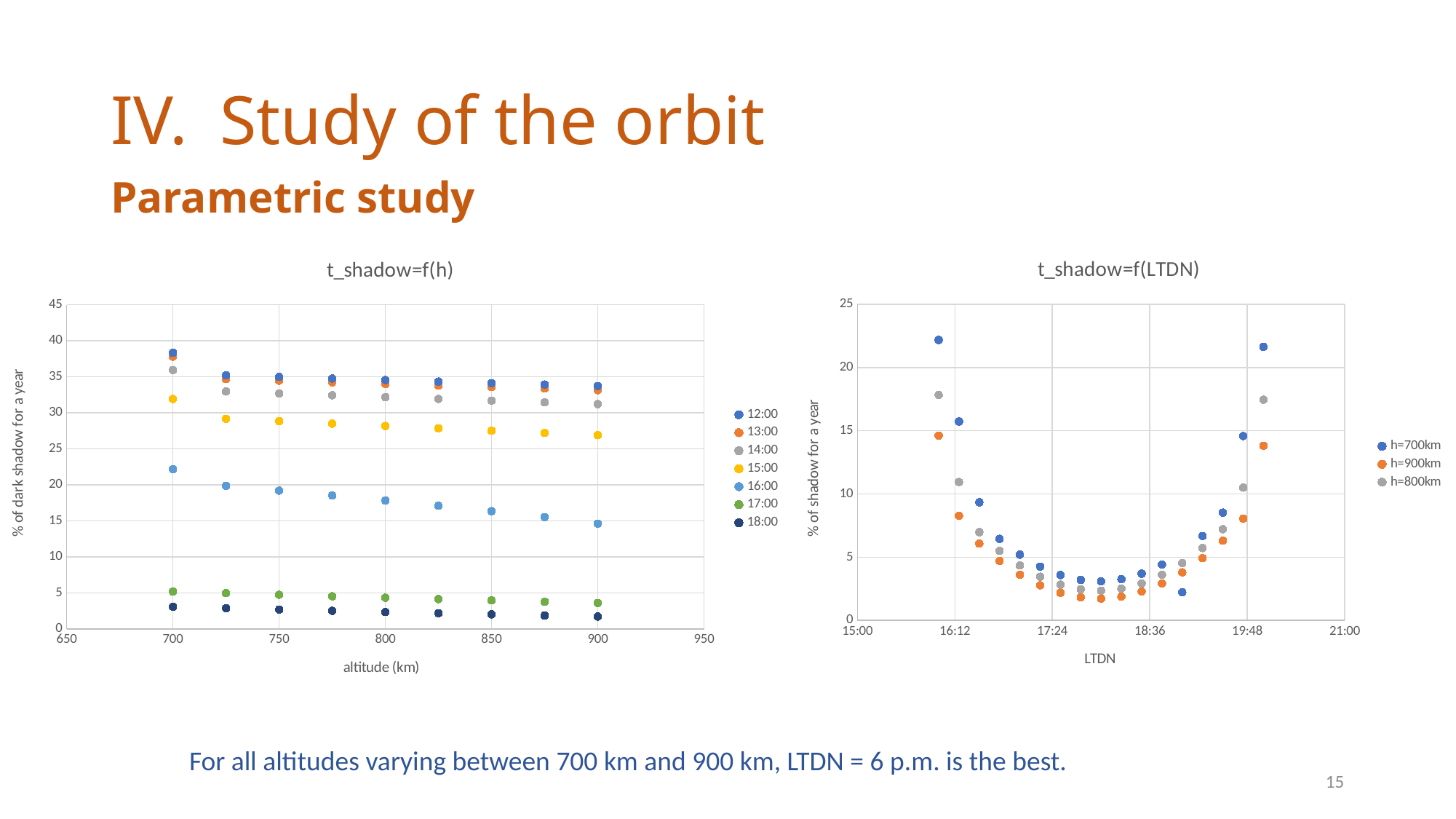
How many series does the legend of the right chart t_shadow=f(LTDN) list? 3 In the left chart t_shadow=f(h), how many altitude points are plotted for the 12:00 series? 9 What kind of chart is the left chart titled t_shadow=f(h)? scatter chart In the left chart t_shadow=f(h), which series has the highest values across all altitudes? 12:00 In the left chart t_shadow=f(h), which series has the lowest values across all altitudes? 18:00 How many series does the legend of the left chart t_shadow=f(h) list? 7 What is the x-axis label of the right chart t_shadow=f(LTDN)? LTDN In the left chart t_shadow=f(h), at 700 km, which series has the larger value: 12:00 or 16:00? 12:00 In the left chart t_shadow=f(h), do the values of the 16:00 series rise or fall as altitude increases from 700 km to 900 km? fall In the left chart t_shadow=f(h), is the value for the 18:00 series at 900 km greater or less than 5? less In the right chart t_shadow=f(LTDN), is the highest value of the h=700km series greater or less than 20? greater In the left chart t_shadow=f(h), is the value for the 16:00 series at 700 km greater or less than 20? greater